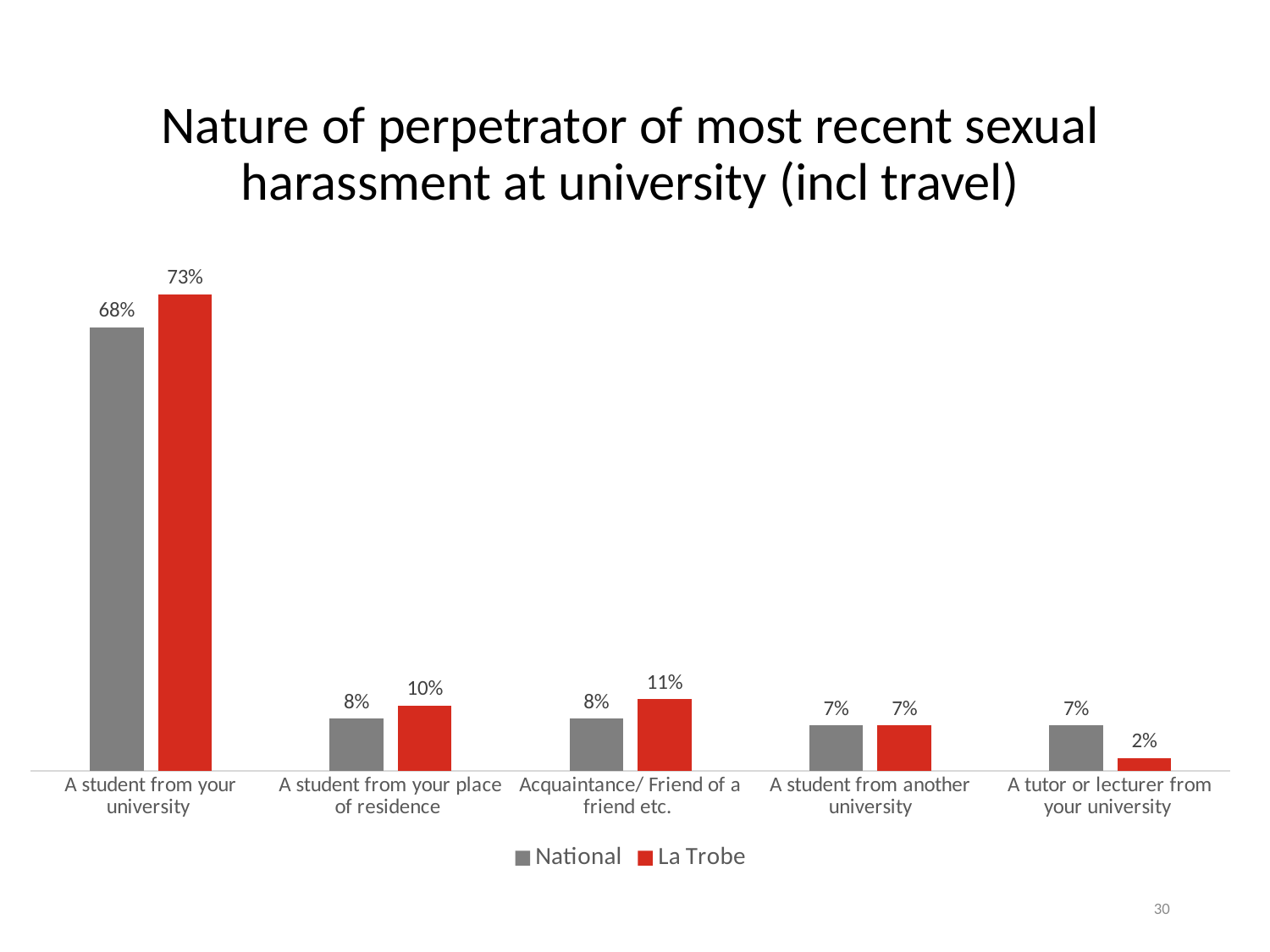
How many series does the legend list? 2 What kind of chart is shown on the slide? Bar chart How many categories are shown on the x axis? 5 Which category has the highest La Trobe value? A student from your university What is the La Trobe value for 'A tutor or lecturer from your university'? 2% Which is larger for 'A student from your place of residence', the National value or the La Trobe value? La Trobe Which category has the lowest La Trobe value? A tutor or lecturer from your university What is the difference between the La Trobe and National values for 'A student from your university'? 5% What is the National value for 'A student from your university'? 68% What is the La Trobe value for 'Acquaintance/ Friend of a friend etc.'? 11% Which series is shown in red? La Trobe What is the difference between the National and La Trobe values for 'A tutor or lecturer from your university'? 5%